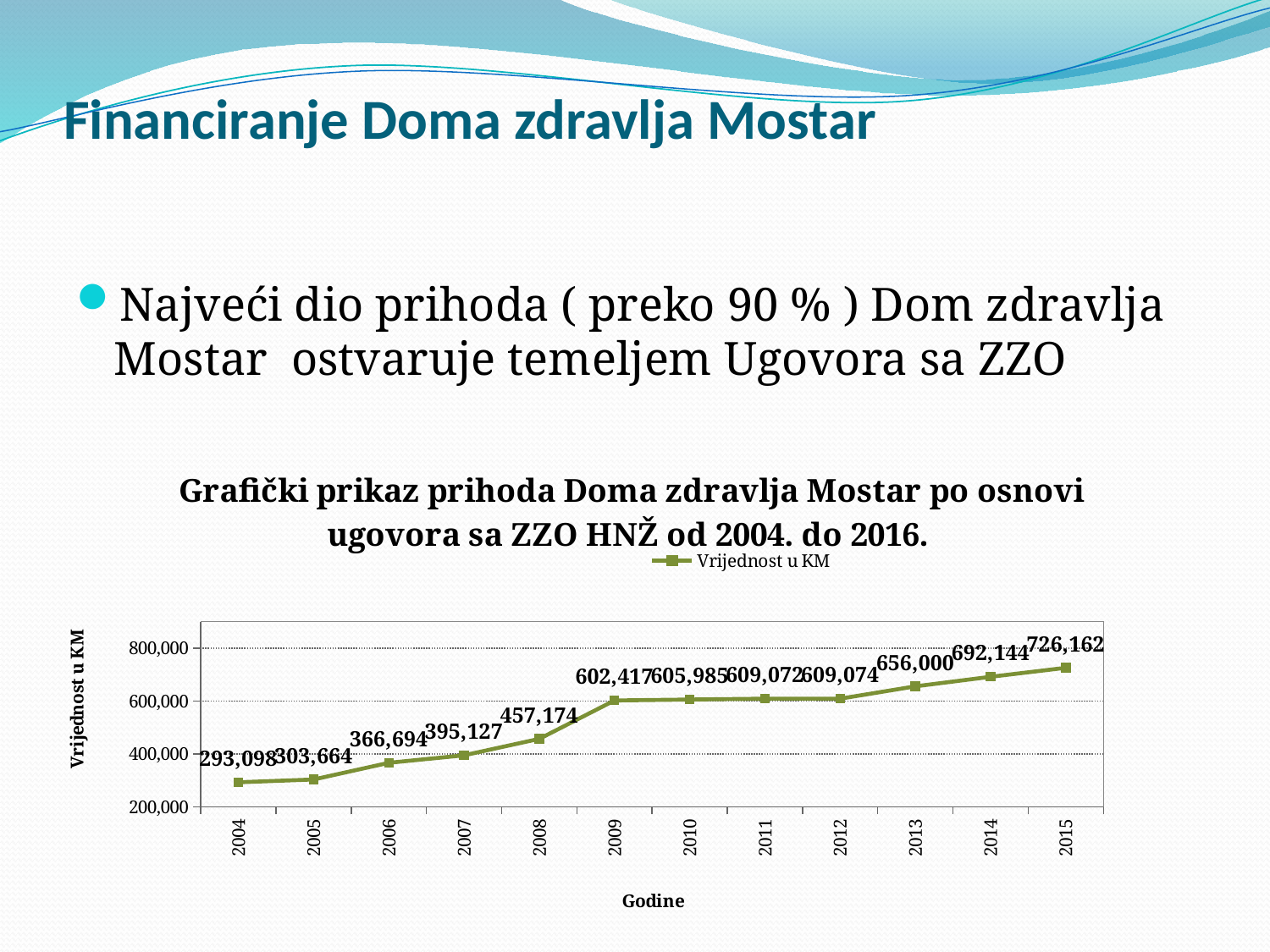
What is the difference between the values for 2015 and 2004? 433,064 Which is larger, the value for 2006 or the value for 2007? 2007 What is the difference between the values for 2009 and 2008? 145,243 What is the value for 2004? 293,098 What type of chart is shown on the slide? line chart What is the value for 2015? 726,162 Which year has the lowest value? 2004 Do the values rise or fall from 2004 to 2015? rise What is the name of the series shown in the legend? Vrijednost u KM Which year has the highest value? 2015 How many years are plotted on the x axis? 12 What is the value for 2009? 602,417